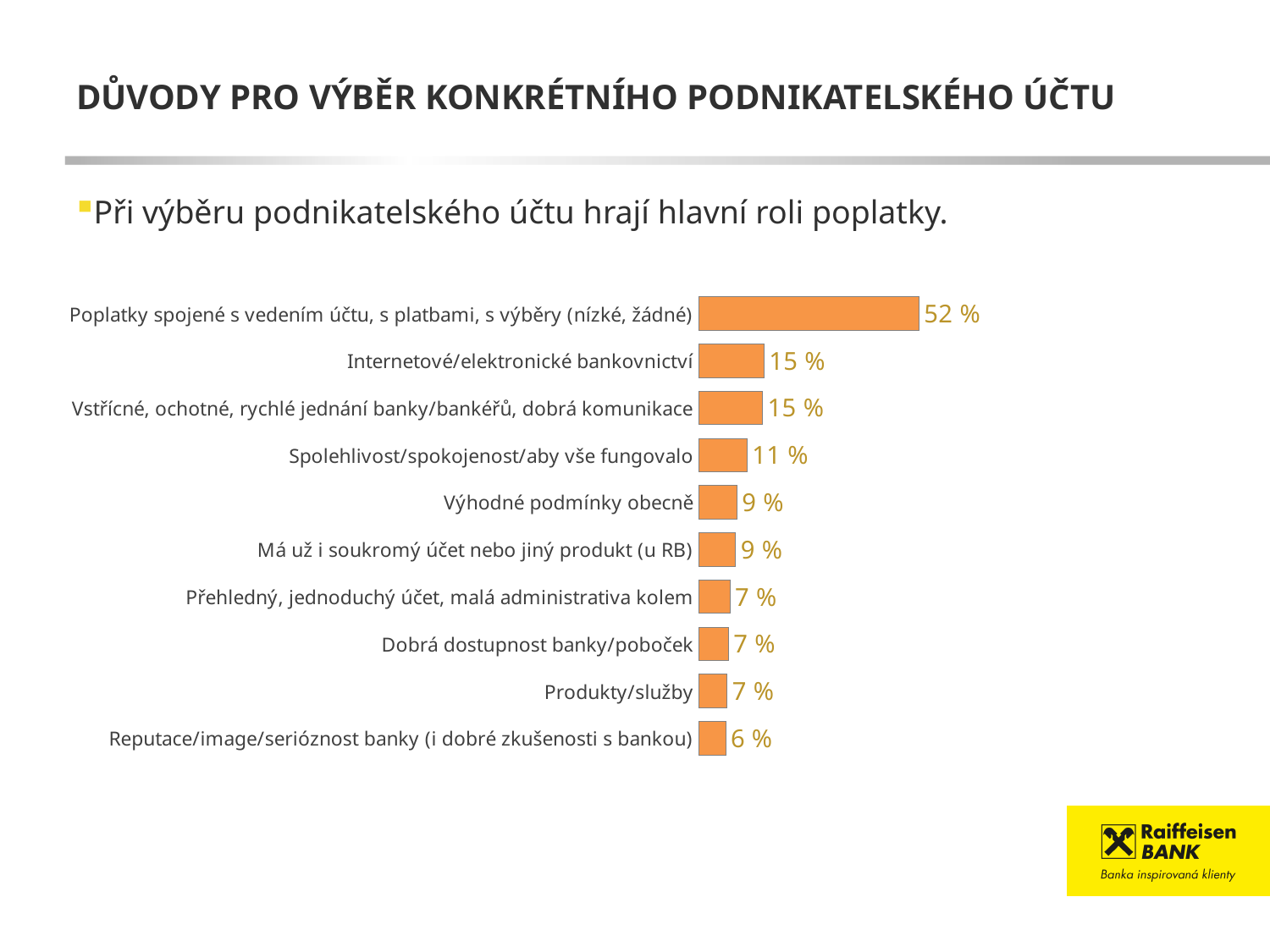
What is the value for "Výhodné podmínky obecně"? 9 % What kind of chart is shown on the slide? Bar chart What is the value for "Spolehlivost/spokojenost/aby vše fungovalo"? 11 % What is the value for "Reputace/image/serióznost banky (i dobré zkušenosti s bankou)"? 6 % Which category has the lowest value? Reputace/image/serióznost banky (i dobré zkušenosti s bankou) Which category has the highest value? Poplatky spojené s vedením účtu, s platbami, s výběry (nízké, žádné) What is the value for "Internetové/elektronické bankovnictví"? 15 % What colour are the bars in the chart? Orange How many categories are shown in the chart? 10 What is the difference between the value for "Poplatky spojené s vedením účtu, s platbami, s výběry (nízké, žádné)" and the value for "Internetové/elektronické bankovnictví"? 37 % What is the difference between the value for "Spolehlivost/spokojenost/aby vše fungovalo" and the value for "Produkty/služby"? 4 % Which is larger: the value for "Má už i soukromý účet nebo jiný produkt (u RB)" or the value for "Dobrá dostupnost banky/poboček"? Má už i soukromý účet nebo jiný produkt (u RB)